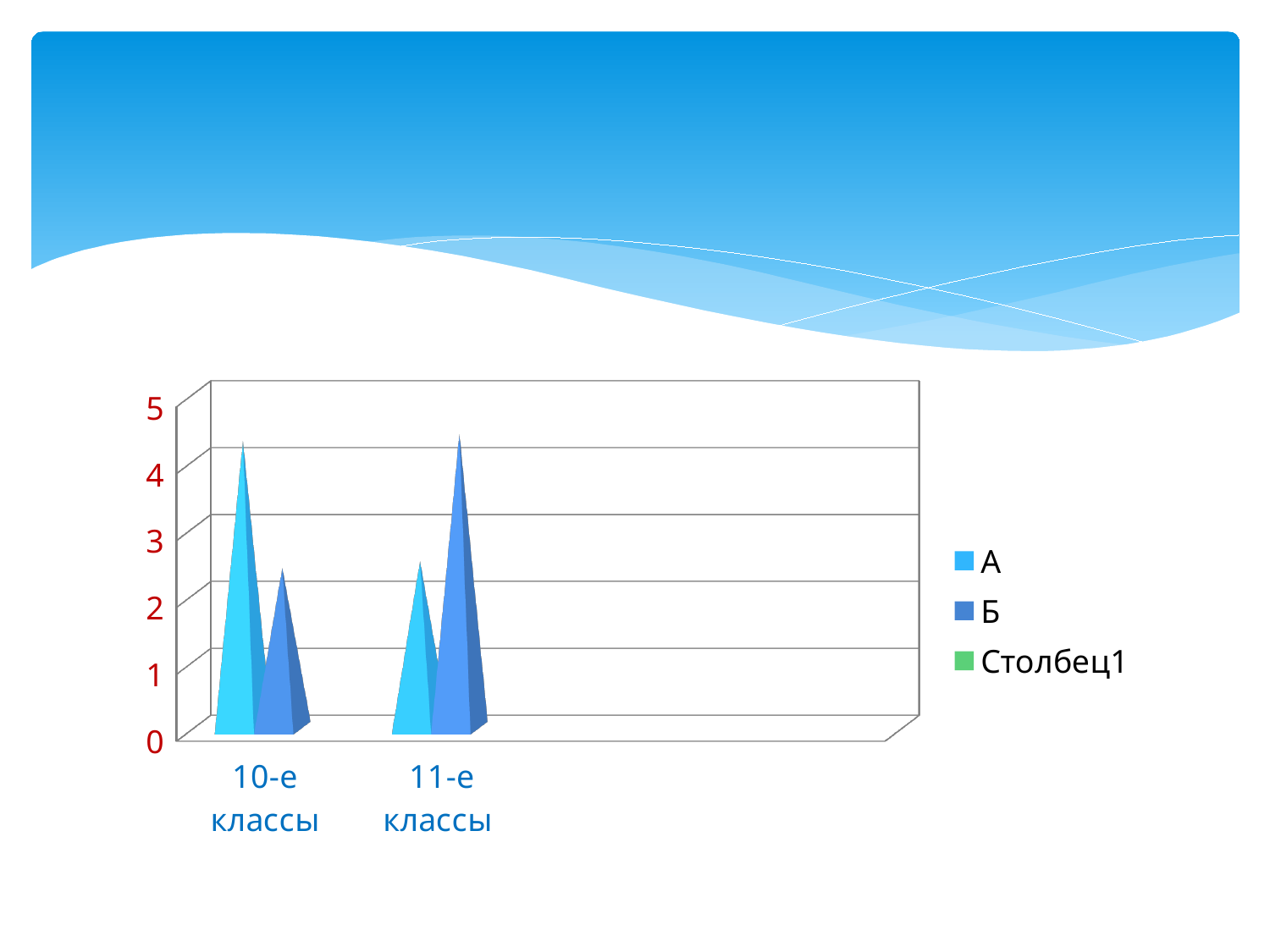
Is the value of series Б for 11-е классы greater or less than 4? greater Is the value of series А for 11-е классы greater or less than 3? less Which series has the highest value within the 10-е классы category? А Which series has the larger value for 10-е классы, А or Б? А What are the three entries listed in the chart's legend? А, Б, Столбец1 How many categories are shown on the x axis of the chart? 2 Which series has the larger value for 11-е классы, А or Б? Б How many series does the chart's legend list? 3 What is the highest value shown on the chart's vertical axis? 5 Is the value of series Б for 10-е классы greater or less than 3? less What kind of chart is shown on the slide? bar chart